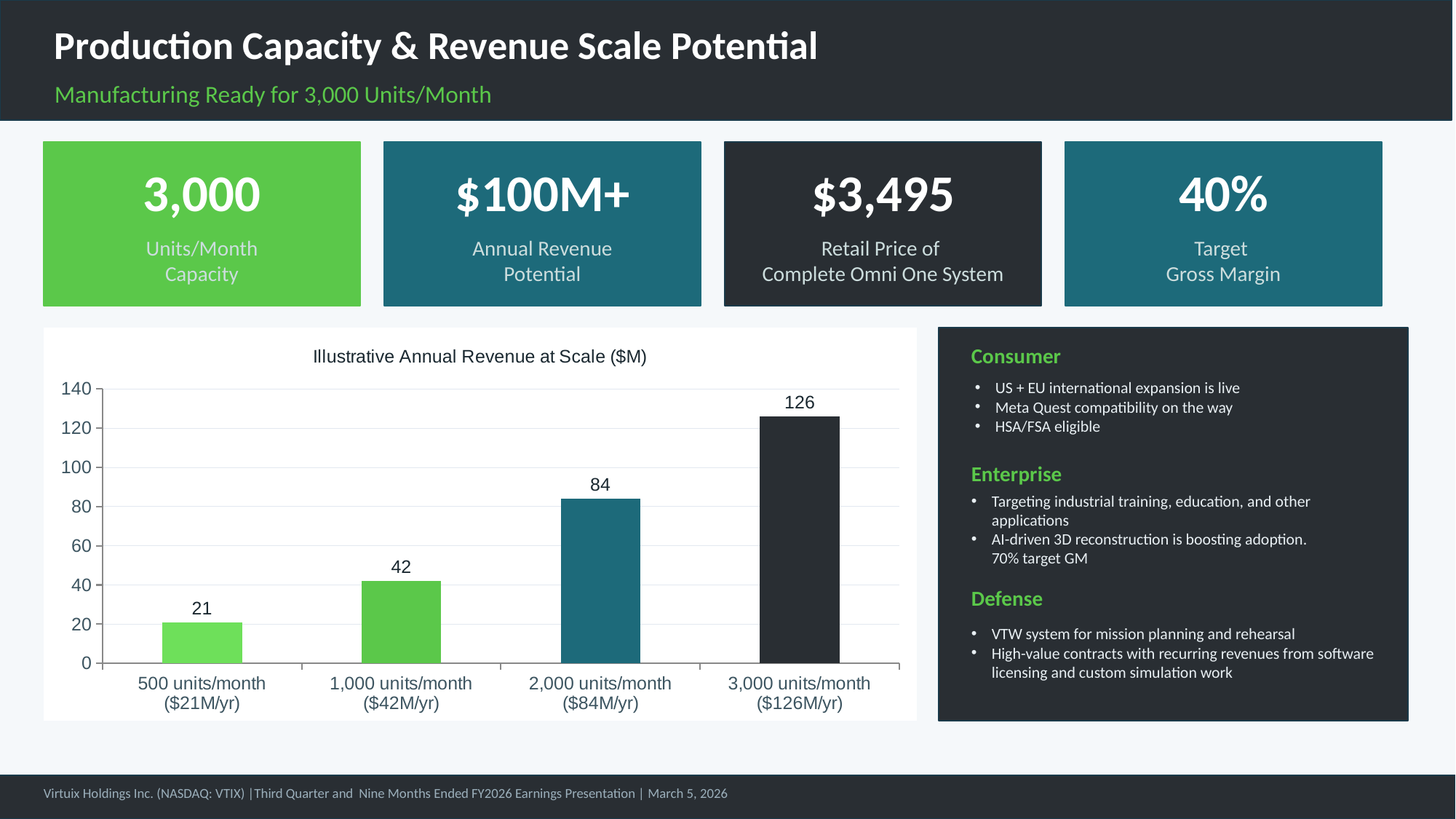
Which is larger, the value for 2,000 units/month or the value for 1,000 units/month? 2,000 units/month What is the difference between the values for 3,000 units/month and 1,000 units/month? 84 What is the value for 3,000 units/month in the chart? 126 What is the value for 500 units/month in the chart? 21 What kind of chart is shown on the slide? Bar chart Is the value for 3,000 units/month greater or less than 120? greater Which category has the lowest value in the chart? 500 units/month Which category has the highest value in the chart? 3,000 units/month How many categories are shown in the chart? 4 Do the values rise or fall from left to right along the x axis? Rise What is the title of the chart? Illustrative Annual Revenue at Scale ($M) What is the value for 2,000 units/month in the Illustrative Annual Revenue at Scale chart? 84